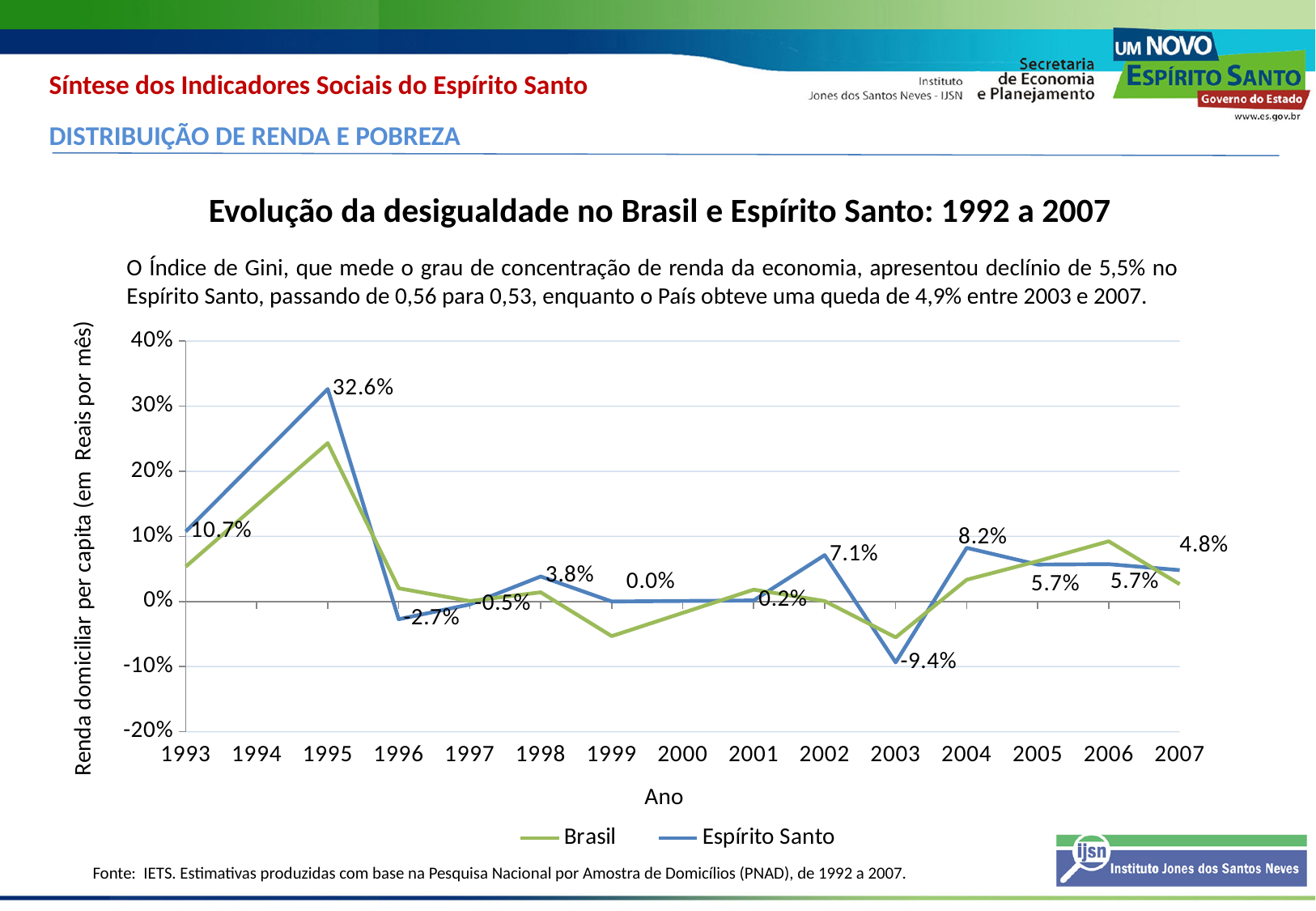
In which year does the Espírito Santo series reach its lowest value? 2003 In 1995, which series has the higher value, Brasil or Espírito Santo? Espírito Santo What type of chart is shown on the slide? line chart What is the difference between the Espírito Santo values in 2004 and 2003? 17.6 percentage points How many series does the legend list? 2 What is the value for Espírito Santo in 1995? 32.6% What is the value for Espírito Santo in 2007? 4.8% How many years are shown on the x axis? 15 What is the value for Espírito Santo in 2003? -9.4% What is the title of the chart? Evolução da desigualdade no Brasil e Espírito Santo: 1992 a 2007 In which year does the Espírito Santo series reach its highest value? 1995 Is the value for Brasil in 1995 greater or less than 20%? greater